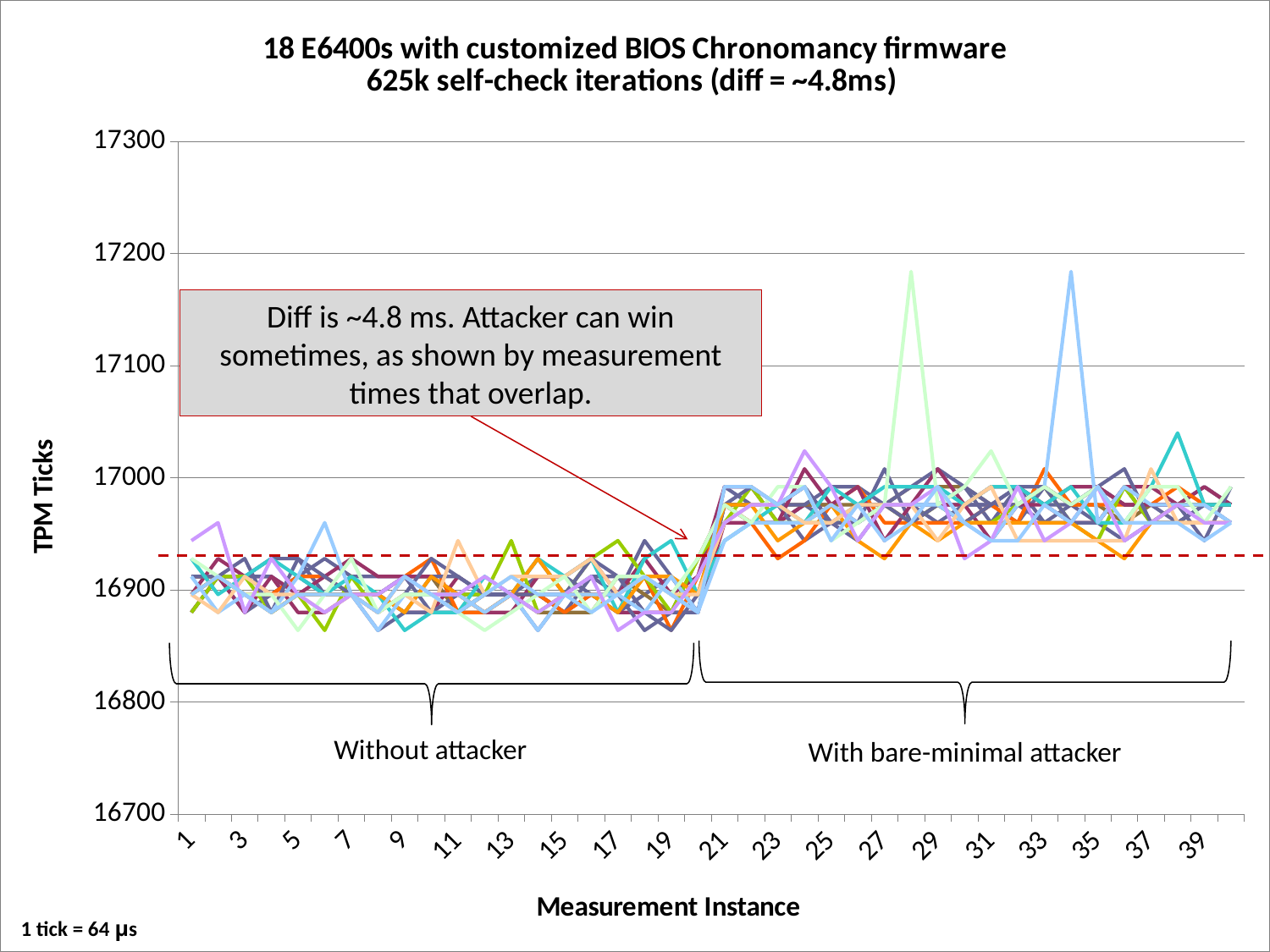
Are the values at measurement instance 1 greater or less than 17000? less Which label is given to the measurement instances on the left side of the chart (roughly instances 1 to 20)? Without attacker Is the lowest value plotted on the chart greater or less than 16800? greater Are the values at measurement instance 30 higher or lower than the values at measurement instance 10? higher Are the values at measurement instance 15 greater or less than 17000? less What kind of chart is shown on the slide? line chart Are the values at measurement instance 5 higher or lower than the values at measurement instance 35? lower Do the plotted TPM Ticks values generally rise or fall as the measurement instance increases from 1 to 40? rise What is the title of the chart? 18 E6400s with customized BIOS Chronomancy firmware 625k self-check iterations (diff = ~4.8ms)